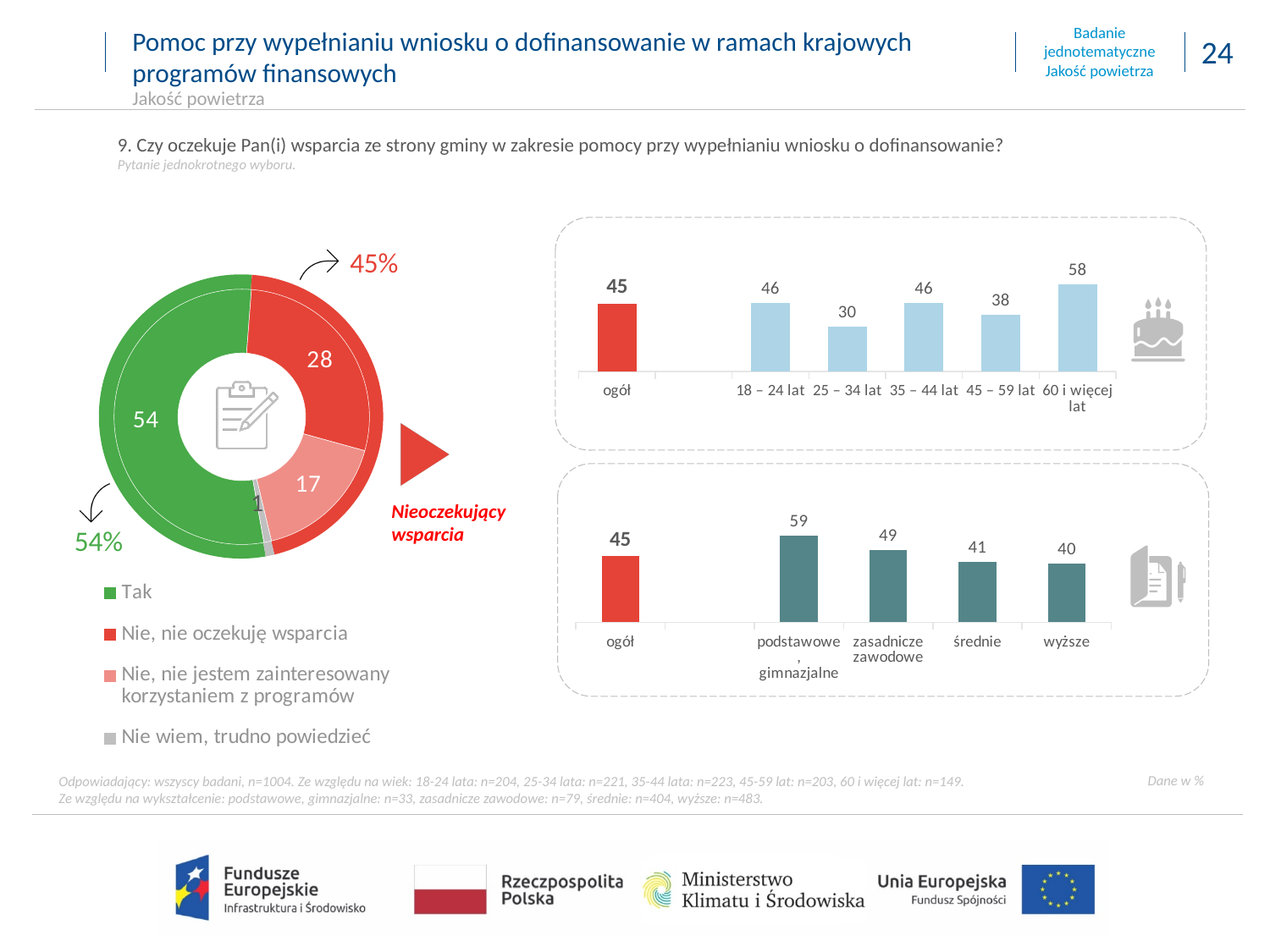
In the top-right bar chart by age, which age group has the lowest value? 25 – 34 lat In the top-right bar chart by age, how many bars are plotted? 6 In the bottom-right bar chart by education, which category has the highest value? podstawowe, gimnazjalne In the donut chart on the left, how many entries does the legend list? 4 In the bottom-right bar chart by education, what is the value for "wyższe"? 40 In the top-right bar chart by age, what is the difference between "60 i więcej lat" and "45 – 59 lat"? 20 In the donut chart on the left, what is the combined share labelled for the two "Nie" answers (shown next to the red arrow)? 45% In the bottom-right bar chart by education, do the values rise or fall from "podstawowe, gimnazjalne" to "wyższe"? fall In the top-right bar chart by age, what is the value for "60 i więcej lat"? 58 In the donut chart on the left, what is the value for "Tak"? 54 In the bottom-right bar chart by education, which is larger: "zasadnicze zawodowe" or "średnie"? zasadnicze zawodowe In the donut chart on the left, what is the value for "Nie, nie jestem zainteresowany korzystaniem z programów"? 17